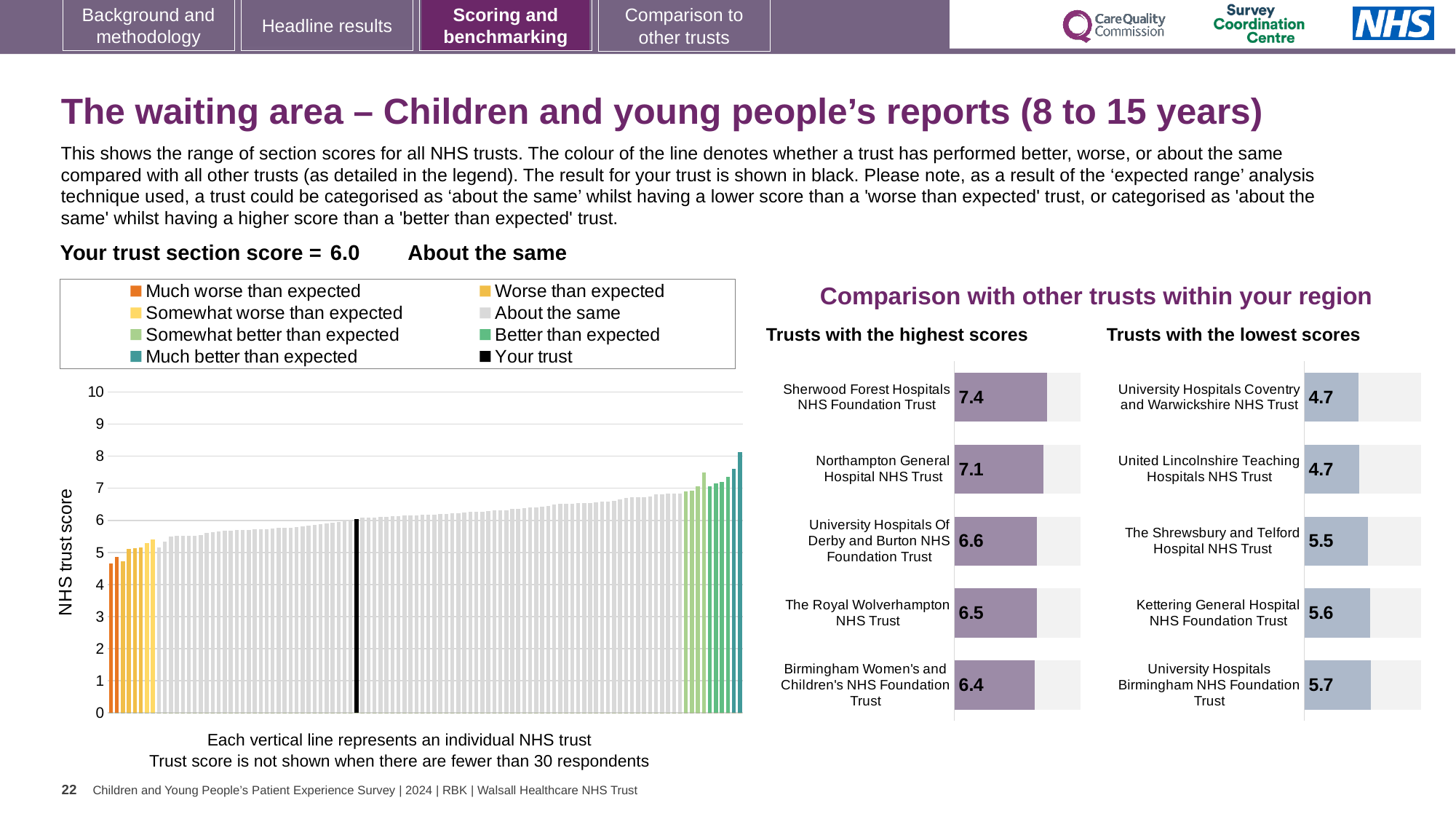
How many trusts are shown in the 'Trusts with the lowest scores' chart? 5 In the main NHS trust score chart on the left, do the bar values rise or fall from left to right? rise In the 'Trusts with the lowest scores' chart, what is the score for The Shrewsbury and Telford Hospital NHS Trust? 5.5 How many entries does the legend of the main NHS trust score chart on the left list? 8 In the 'Trusts with the highest scores' chart, what is the score for Sherwood Forest Hospitals NHS Foundation Trust? 7.4 In the 'Trusts with the lowest scores' chart, what is the score for University Hospitals Coventry and Warwickshire NHS Trust? 4.7 In the 'Trusts with the lowest scores' chart, which trust has the highest score? University Hospitals Birmingham NHS Foundation Trust In the 'Trusts with the highest scores' chart, what is the score for The Royal Wolverhampton NHS Trust? 6.5 In the 'Trusts with the highest scores' chart, which trust has the highest score? Sherwood Forest Hospitals NHS Foundation Trust In the main NHS trust score chart on the left, what is the section score for your trust? 6.0 In the 'Trusts with the lowest scores' chart, which has the larger score: Kettering General Hospital NHS Foundation Trust or The Shrewsbury and Telford Hospital NHS Trust? Kettering General Hospital NHS Foundation Trust In the 'Trusts with the highest scores' chart, what is the difference between the scores of Sherwood Forest Hospitals NHS Foundation Trust and Northampton General Hospital NHS Trust? 0.3